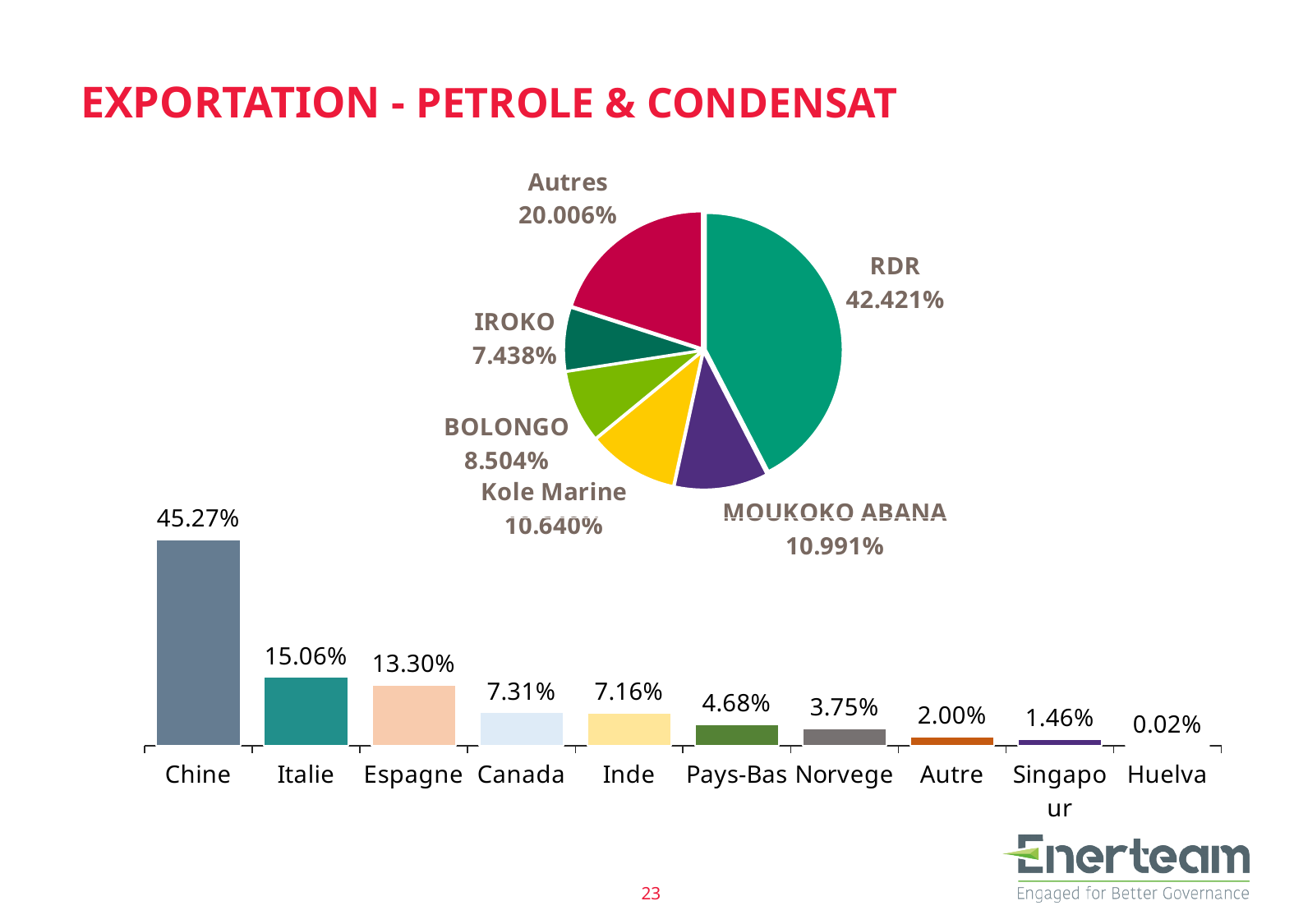
In the bar chart at the bottom of the slide, how many categories are shown? 10 In the bar chart at the bottom of the slide, what is the value for Chine? 45.27% In the pie chart at the top of the slide, what share does RDR have? 42.421% In the bar chart at the bottom of the slide, what is the value for Norvege? 3.75% In the pie chart at the top of the slide, which slice is the smallest? IROKO In the bar chart at the bottom of the slide, which category has the lowest value? Huelva In the pie chart at the top of the slide, how many slices are there? 6 What type of chart is shown at the bottom of the slide? Bar chart In the bar chart at the bottom of the slide, what is the difference between the values for Chine and Italie? 30.21% In the pie chart at the top of the slide, what is the difference between the RDR and Autres shares? 22.415% In the pie chart at the top of the slide, which slice is the largest? RDR In the pie chart at the top of the slide, what is the value for Kole Marine? 10.640%